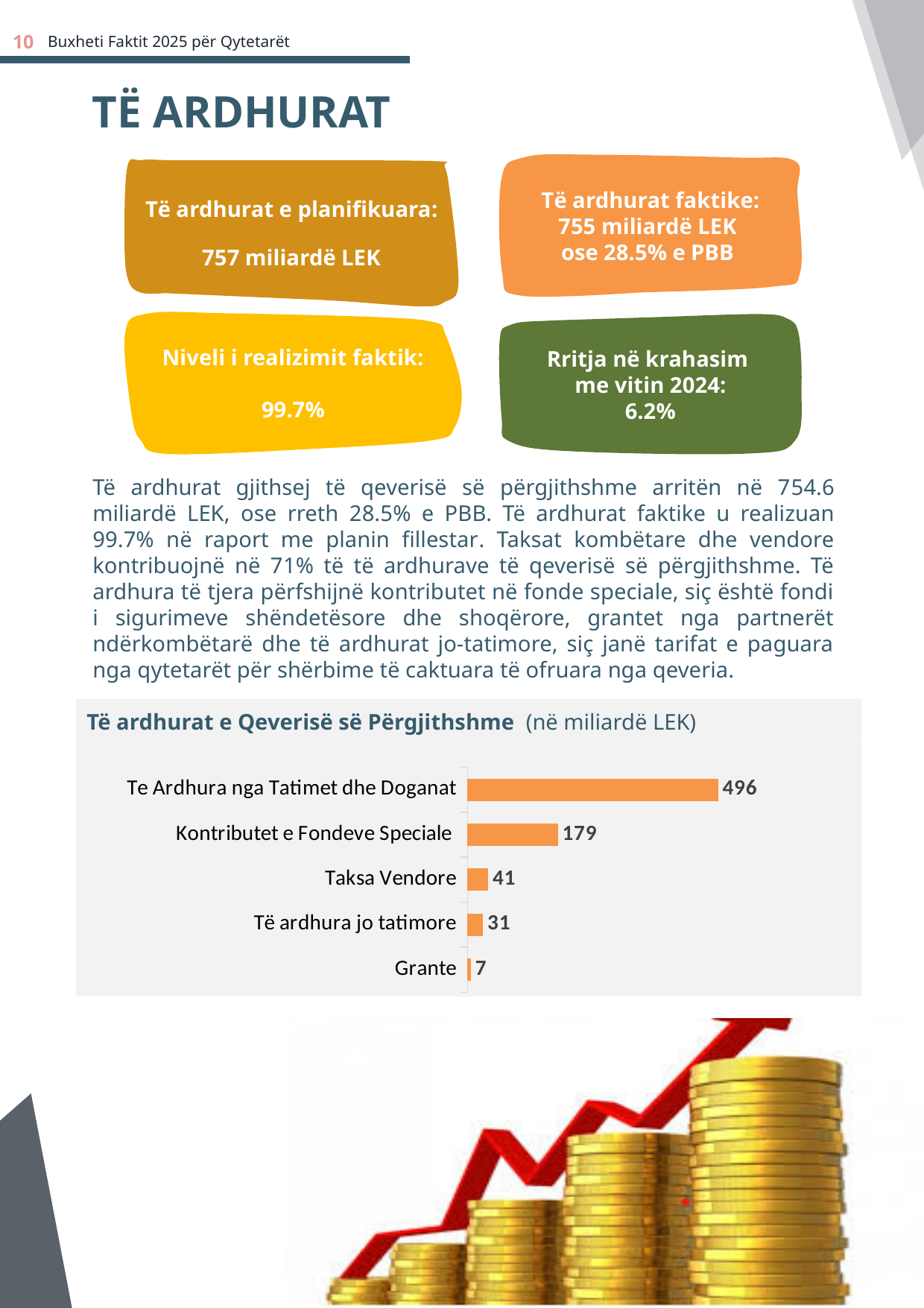
Which is larger, Taksa Vendore or Të ardhura jo tatimore? Taksa Vendore What is the value for Kontributet e Fondeve Speciale? 179 What is the title of the chart? Të ardhurat e Qeverisë së Përgjithshme (në miliardë LEK) What kind of chart is shown? Bar chart What is the value for Të ardhura jo tatimore? 31 What is the value for Taksa Vendore? 41 How many categories are shown in the chart? 5 Which category has the lowest value? Grante Which category has the highest value? Te Ardhura nga Tatimet dhe Doganat What is the difference between Te Ardhura nga Tatimet dhe Doganat and Kontributet e Fondeve Speciale? 317 What is the value for Te Ardhura nga Tatimet dhe Doganat? 496 What is the value for Grante? 7